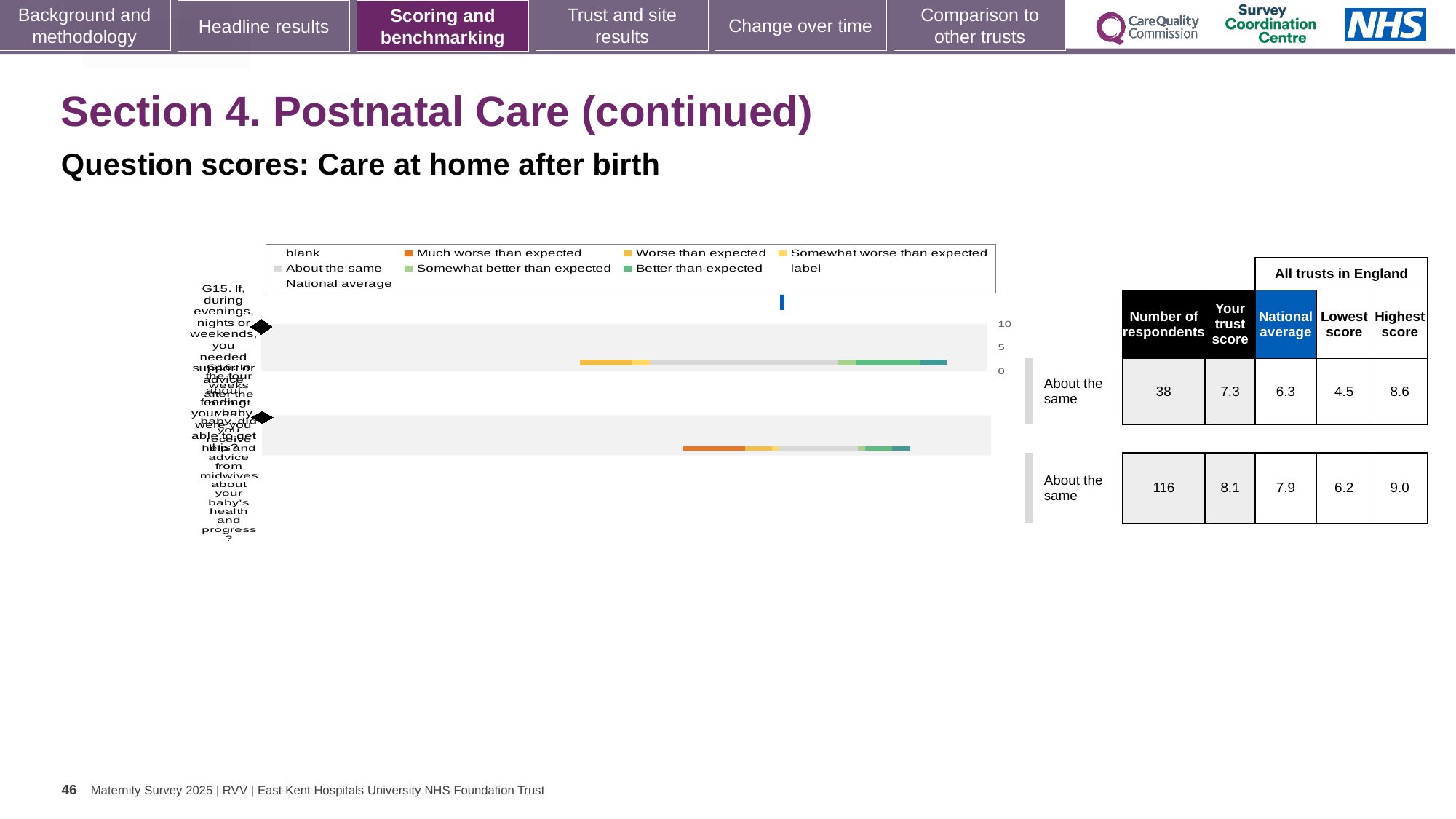
What is the highest score among all trusts in England for question G16? 9.0 What kind of chart is shown on the slide? bar chart What is the difference between the trust score and the national average for question G16? 0.2 What colour represents 'Much worse than expected' in the legend? orange What is the lowest score among all trusts in England for question G15? 4.5 Which question has the higher trust score, G15 or G16? G16 What is the national average for question G16? 7.9 What benchmark category is shown for question G15? About the same What is the difference between the highest and lowest scores for question G15? 4.1 How many questions (bars) are plotted in the chart? 2 How many respondents answered question G15? 38 What is the trust score for question G15? 7.3